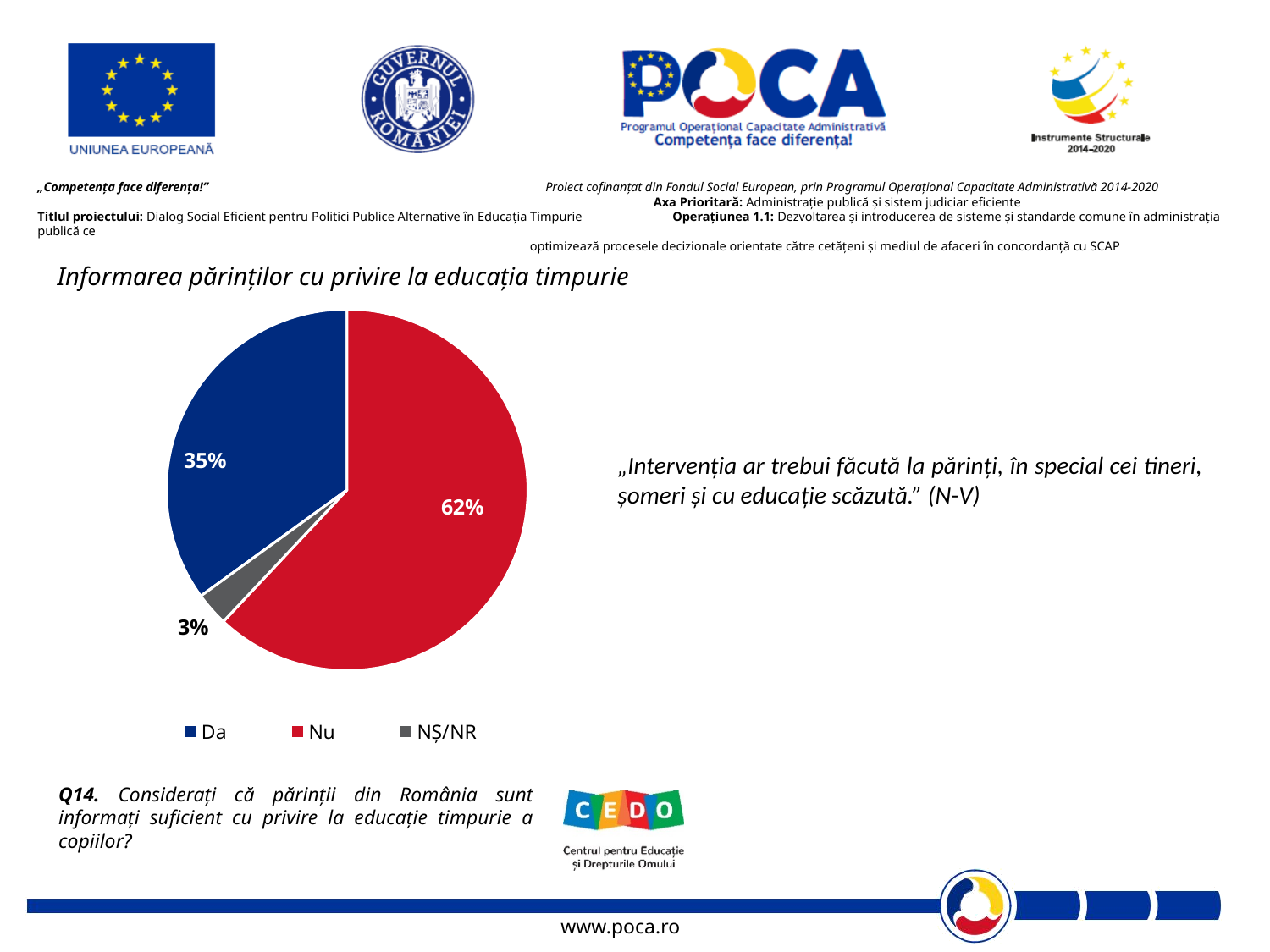
What percentage of the pie chart is labelled "Da"? 35% What is the title of the chart? Informarea părinților cu privire la educația timpurie What type of chart is shown on the slide? pie chart What is the combined share of the "Da" and "Nu" slices? 97% What percentage of the pie chart is labelled "NȘ/NR"? 3% What percentage of the pie chart is labelled "Nu"? 62% Which slice is larger, "Da" or "NȘ/NR"? Da How many categories does the pie chart legend list? 3 Which category has the smallest slice in the pie chart? NȘ/NR Which category has the largest slice in the pie chart? Nu What colour is the "Nu" slice in the pie chart? red What is the difference in percentage points between the "Nu" and "Da" slices? 27